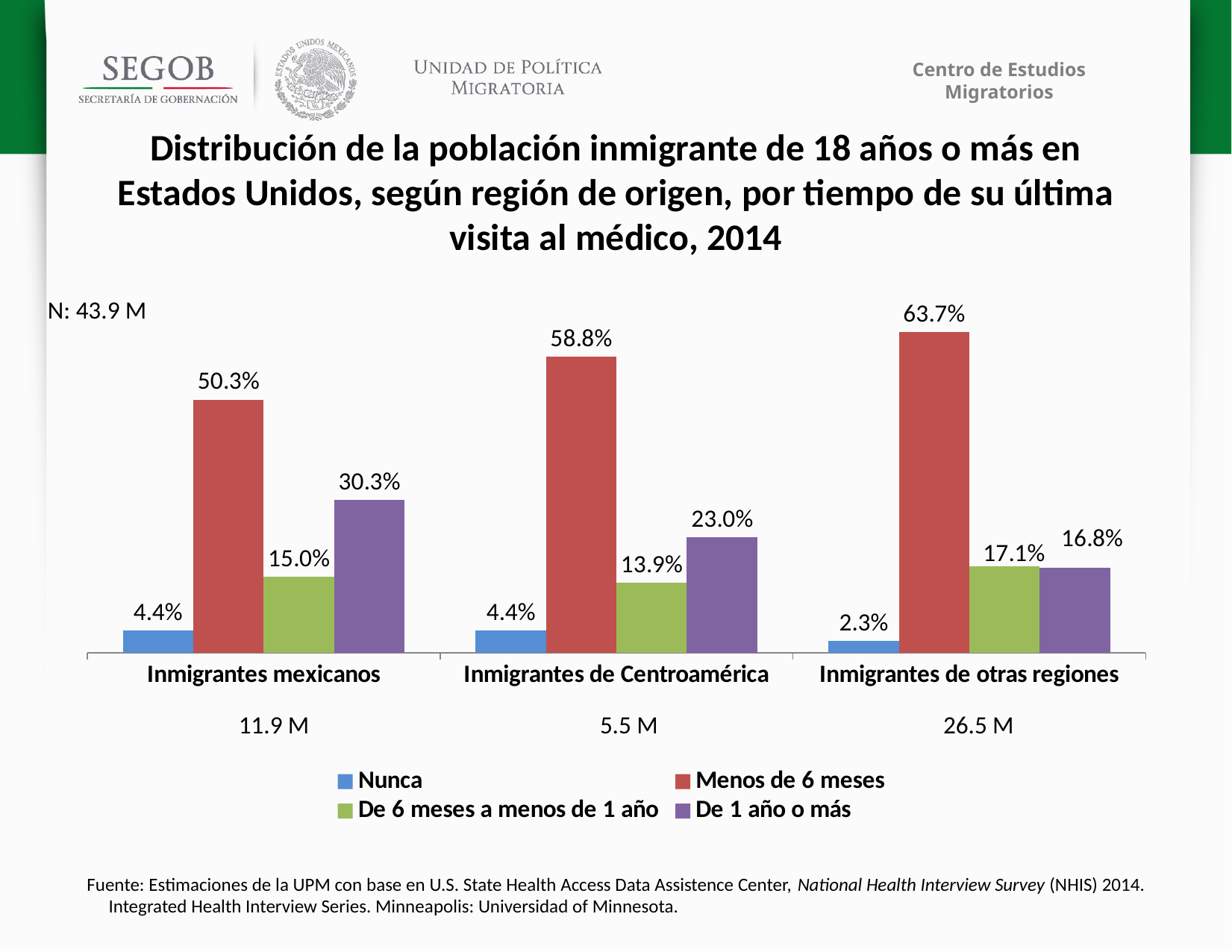
What is the value for "De 1 año o más" for Inmigrantes de Centroamérica? 23.0% What is the value for "Menos de 6 meses" for Inmigrantes mexicanos? 50.3% What is the value for "Nunca" for Inmigrantes de otras regiones? 2.3% What kind of chart is shown on the slide? Bar chart Which is larger for Inmigrantes mexicanos: "De 6 meses a menos de 1 año" or "De 1 año o más"? De 1 año o más What is the difference between the "Menos de 6 meses" values for Inmigrantes de otras regiones and Inmigrantes mexicanos? 13.4% Which region has the lowest value for "De 1 año o más"? Inmigrantes de otras regiones What is the value for "De 6 meses a menos de 1 año" for Inmigrantes de otras regiones? 17.1% Which region has the highest value for "Menos de 6 meses"? Inmigrantes de otras regiones What colour represents the "Nunca" series in the legend? Blue How many regions of origin are shown on the x axis? 3 How many series does the legend list? 4